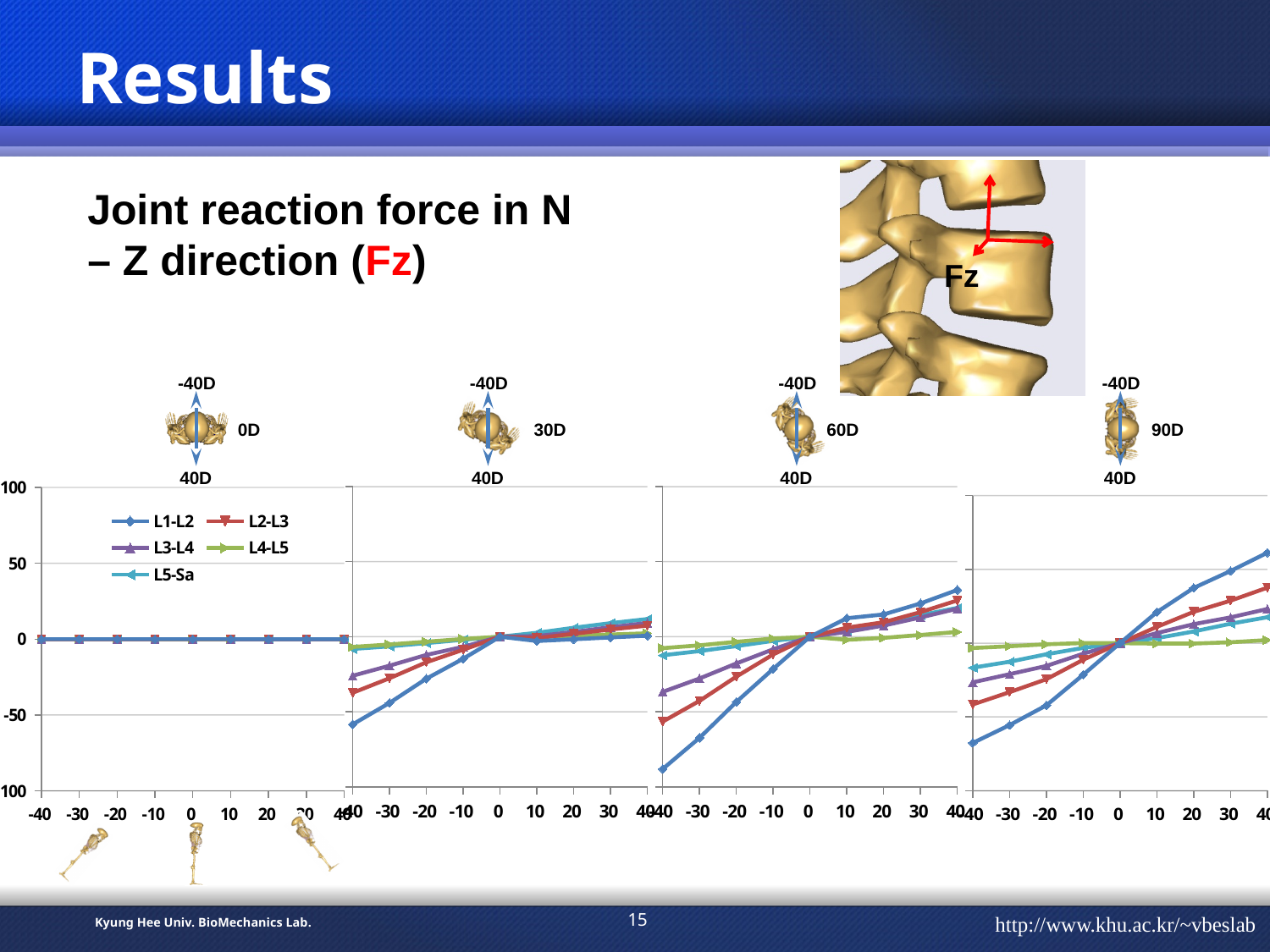
In the 90D chart, does the L1-L2 series rise or fall as the x value increases from -40 to 40? rise How many charts (panels) are shown on the slide? 4 In the 60D chart, is the value of L1-L2 at x = -40 greater or less than -50? less In the 60D chart, which series has the lowest value at x = -40? L1-L2 In the 30D chart, is the value of L2-L3 at x = -40 greater or less than -50? greater In the 60D chart, which series has the highest value at x = 40? L1-L2 What are the series names listed in the legend of the 0D chart? L1-L2, L2-L3, L3-L4, L4-L5, L5-Sa In the 0D chart, do the series rise, fall, or stay flat across the x axis? stay flat In the 90D chart, at x = 40, which is larger: the value for L1-L2 or the value for L4-L5? L1-L2 How many series does the legend in the 0D chart list? 5 What kind of chart is used in the 0D, 30D, 60D and 90D panels? line chart In the 90D chart, is the value of L1-L2 at x = -40 greater or less than -50? less